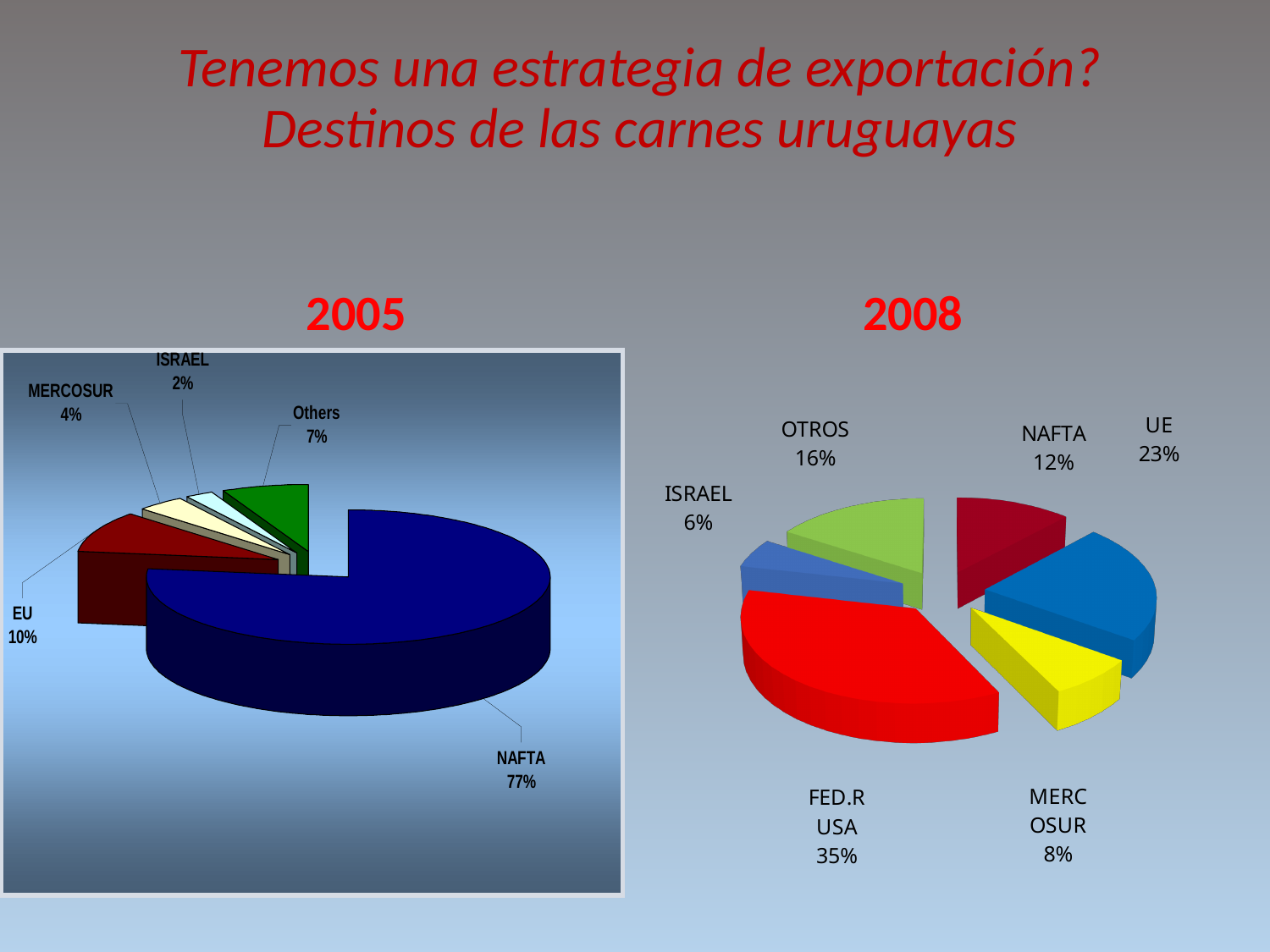
In the 2005 pie chart, how many slices are there? 5 In the 2008 pie chart, which destination has the largest share? FED.R USA What kind of chart is used for the 2008 data? Pie chart In the 2005 pie chart, what is the difference between the Others share and the MERCOSUR share? 3% In the 2005 pie chart, which destination has the smallest share? ISRAEL In the 2008 pie chart, how many slices are there? 6 In the 2005 pie chart, what share does EU have? 10% In the 2008 pie chart, which destination has the smallest share? ISRAEL In the 2008 pie chart, what share does UE have? 23% In the 2008 pie chart, which is larger, the OTROS share or the NAFTA share? OTROS In the 2008 pie chart, what share does FED.R USA have? 35% In the 2005 pie chart, what share does NAFTA have? 77%